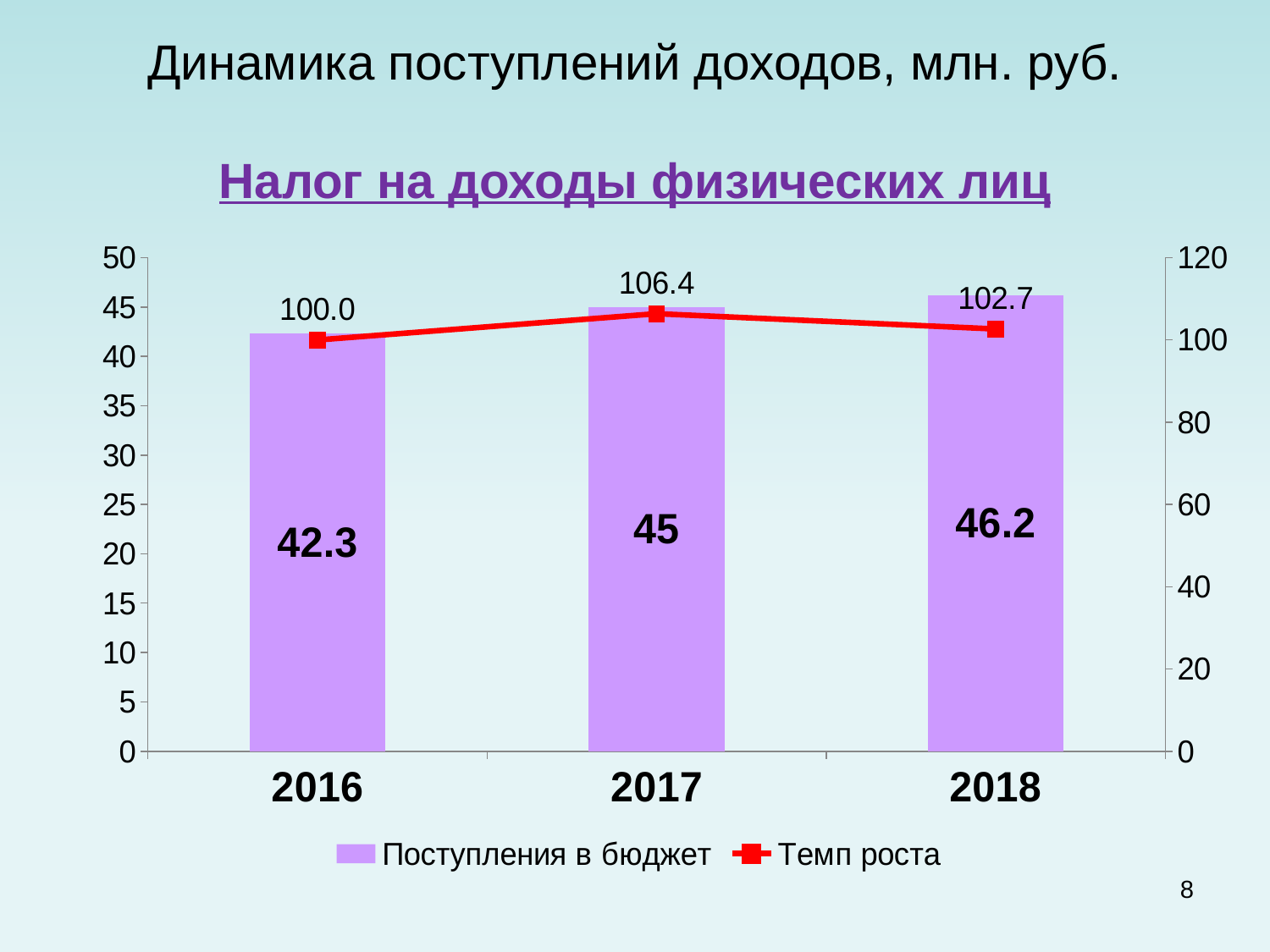
What is the value of "Темп роста" for 2017? 106.4 Do the values of "Поступления в бюджет" rise or fall from 2016 to 2018? rise What is the value of "Темп роста" for 2018? 102.7 How many series does the legend list? 2 How many years are shown on the x axis? 3 Which year has the highest value of "Поступления в бюджет"? 2018 Which year has the lowest value of "Темп роста"? 2016 What is the value of "Поступления в бюджет" for 2018? 46.2 What is the value of "Поступления в бюджет" for 2016? 42.3 What is the difference between "Поступления в бюджет" in 2018 and 2016? 3.9 What is the title of the chart? Налог на доходы физических лиц Which is larger: "Темп роста" in 2017 or in 2018? 2017